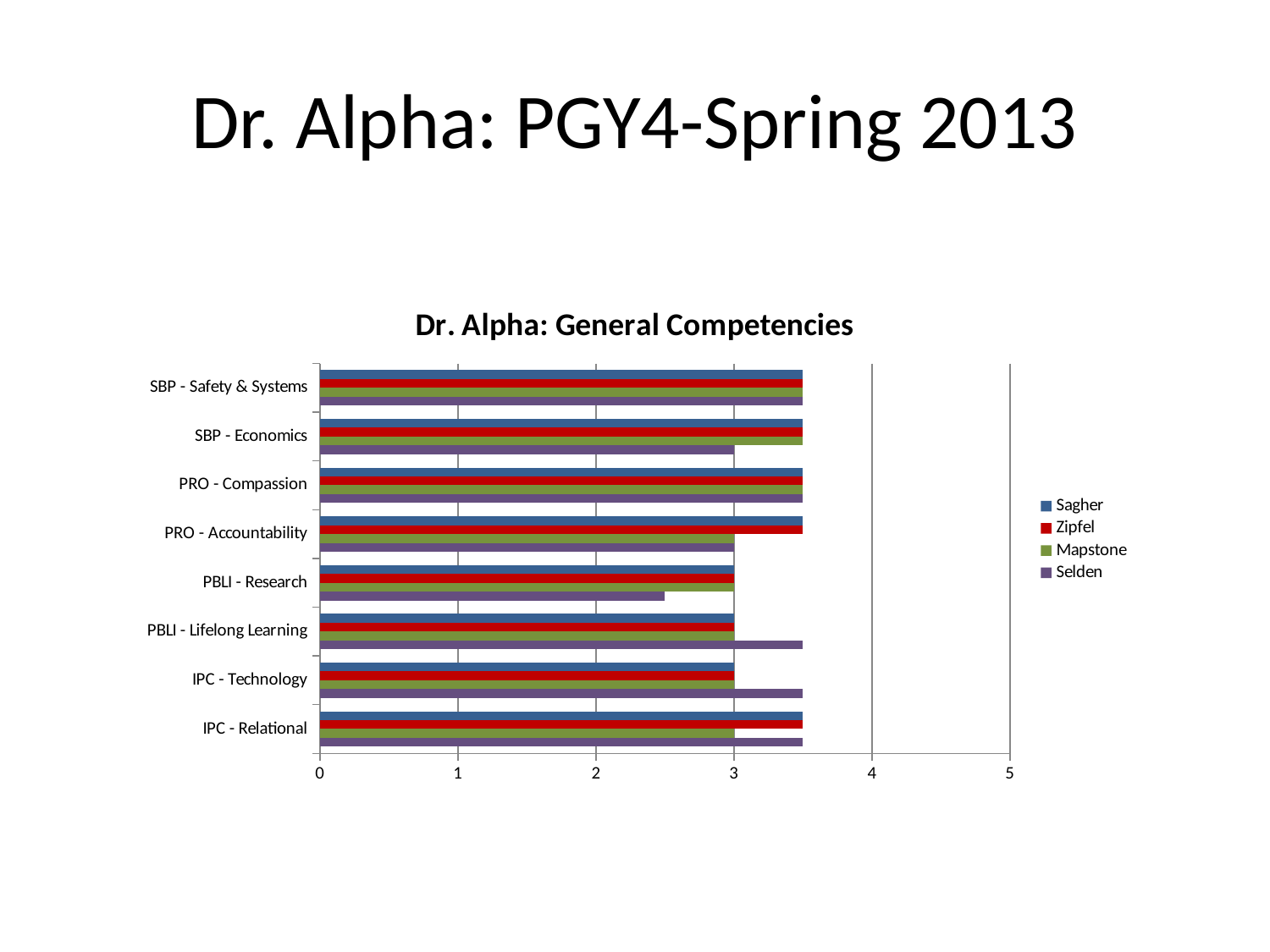
What is the title of the chart? Dr. Alpha: General Competencies For PBLI - Research, which is larger: the Sagher value or the Selden value? Sagher What is the Sagher value for IPC - Technology? 3 Is the Selden value for PBLI - Lifelong Learning greater or less than 3? greater What kind of chart is shown on the slide? bar chart What is the Selden value for SBP - Economics? 3 Is the Selden value for PBLI - Research greater or less than 3? less Which series is shown in red in the legend? Zipfel Is the Sagher value for SBP - Safety & Systems greater or less than 3? greater How many series does the legend list? 4 How many competency categories are shown on the chart? 8 What is the Mapstone value for PBLI - Research? 3